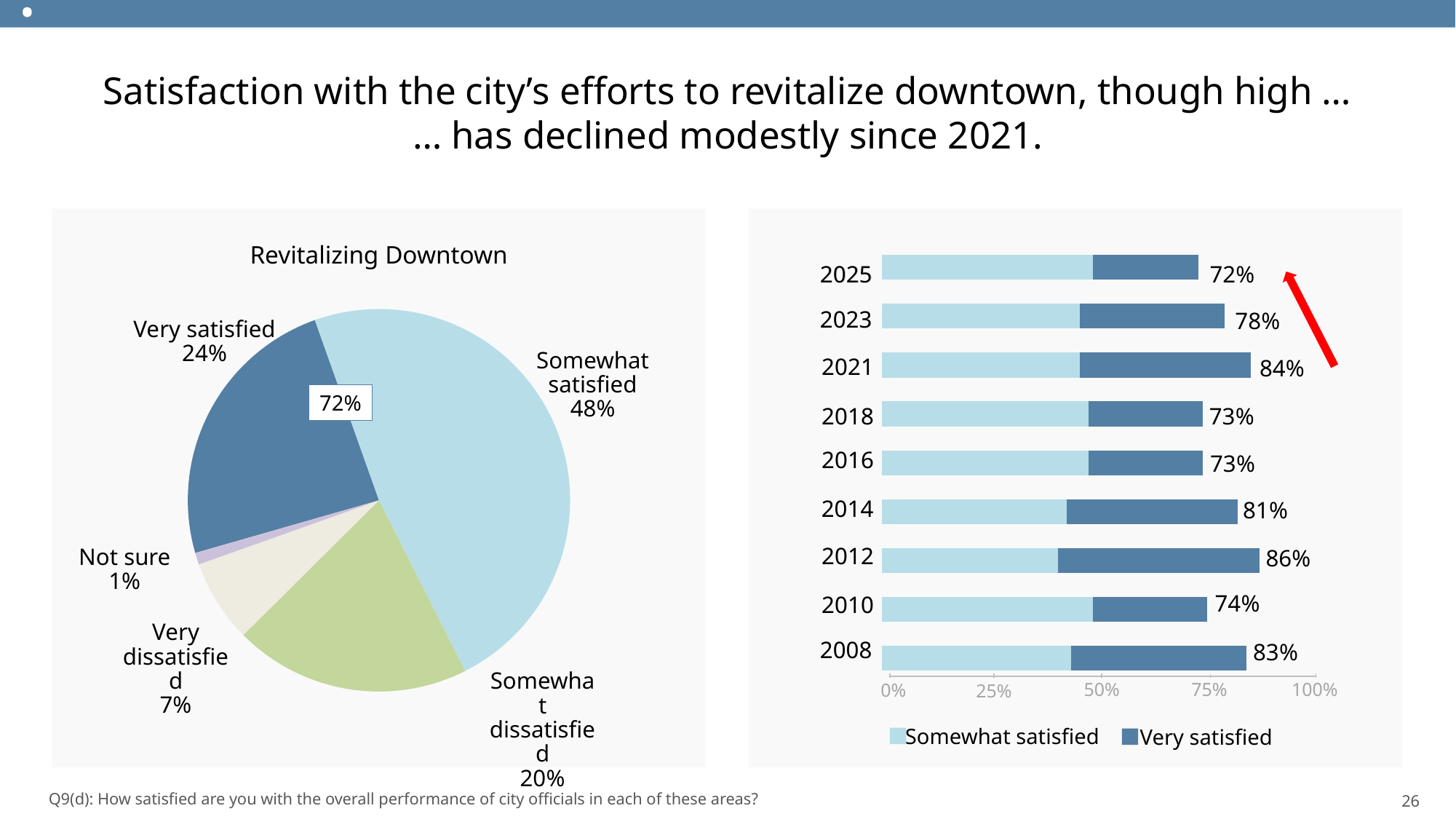
In the bar chart on the right, which year has the lowest labelled percentage? 2025 In the bar chart on the right, what total percentage is labelled for 2021? 84% In the bar chart on the right, what is the difference between the labelled percentages for 2021 and 2025? 12% In the Revitalizing Downtown pie chart, which category has the smallest slice? Not sure What kind of chart is the chart on the left of the slide? Pie chart In the Revitalizing Downtown pie chart, what percentage is labelled for Somewhat satisfied? 48% In the bar chart on the right, which year has the highest labelled percentage? 2012 In the Revitalizing Downtown pie chart, what is the difference between the Very satisfied and Somewhat dissatisfied percentages? 4% In the Revitalizing Downtown pie chart, which category has the largest slice? Somewhat satisfied How many years are shown in the bar chart on the right? 9 How many series does the legend of the bar chart on the right list? 2 How many slices does the Revitalizing Downtown pie chart have? 5